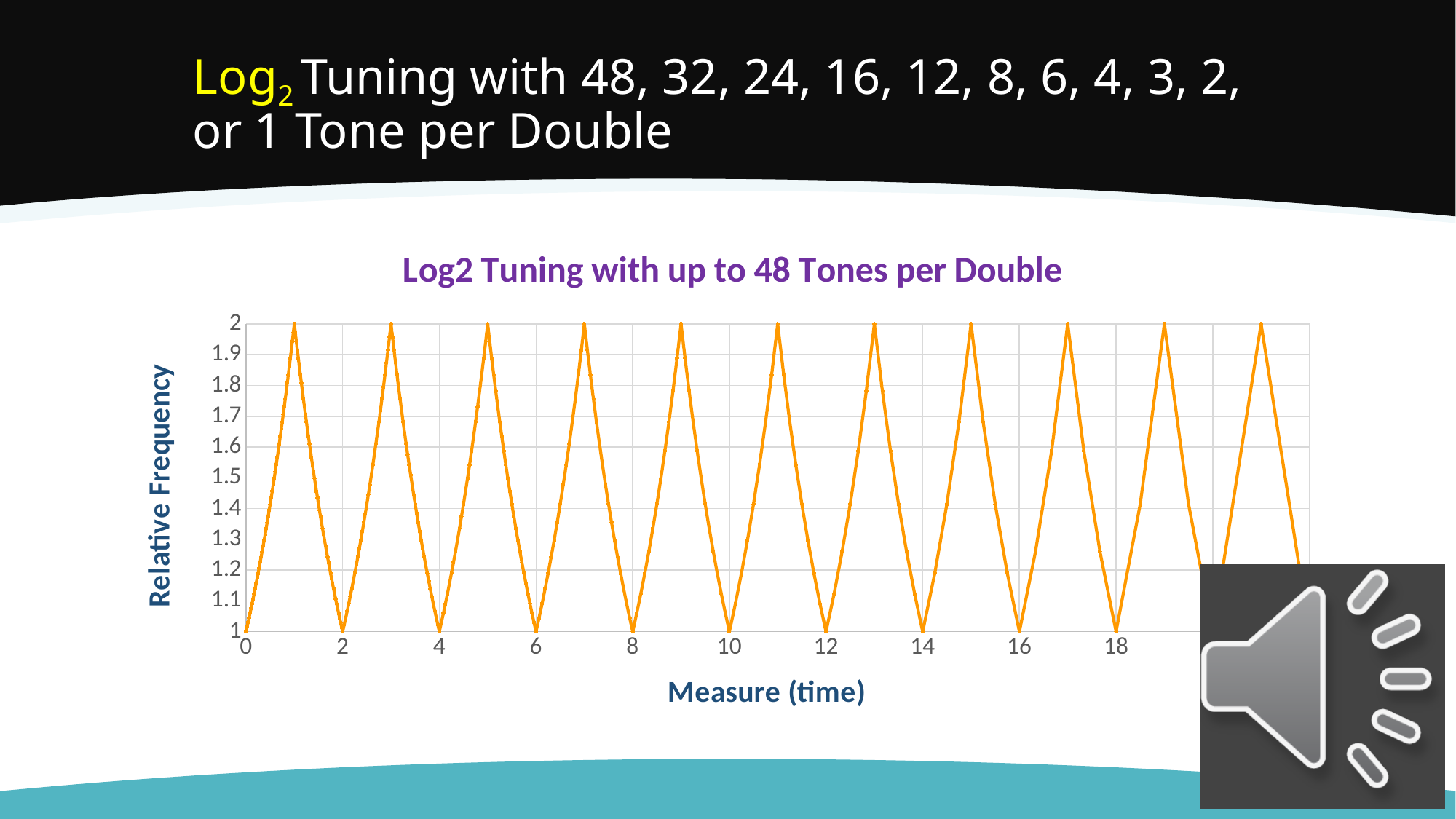
What is the difference between the relative frequency at measure 3 and at measure 4? 1 What is the highest relative frequency reached by the line? 2 Which has the larger relative frequency, measure 5 or measure 6? measure 5 Does the line rise or fall between measure 1 and measure 2? fall What is the label of the vertical axis? Relative Frequency What is the lowest relative frequency reached by the line? 1 What is the chart's title? Log2 Tuning with up to 48 Tones per Double What is the relative frequency at measure 2? 1 Is the relative frequency at measure 7 greater or less than 1.5? greater Does the line rise or fall between measure 0 and measure 1? rise What is the relative frequency at measure 1? 2 What kind of chart is shown on the slide? line chart